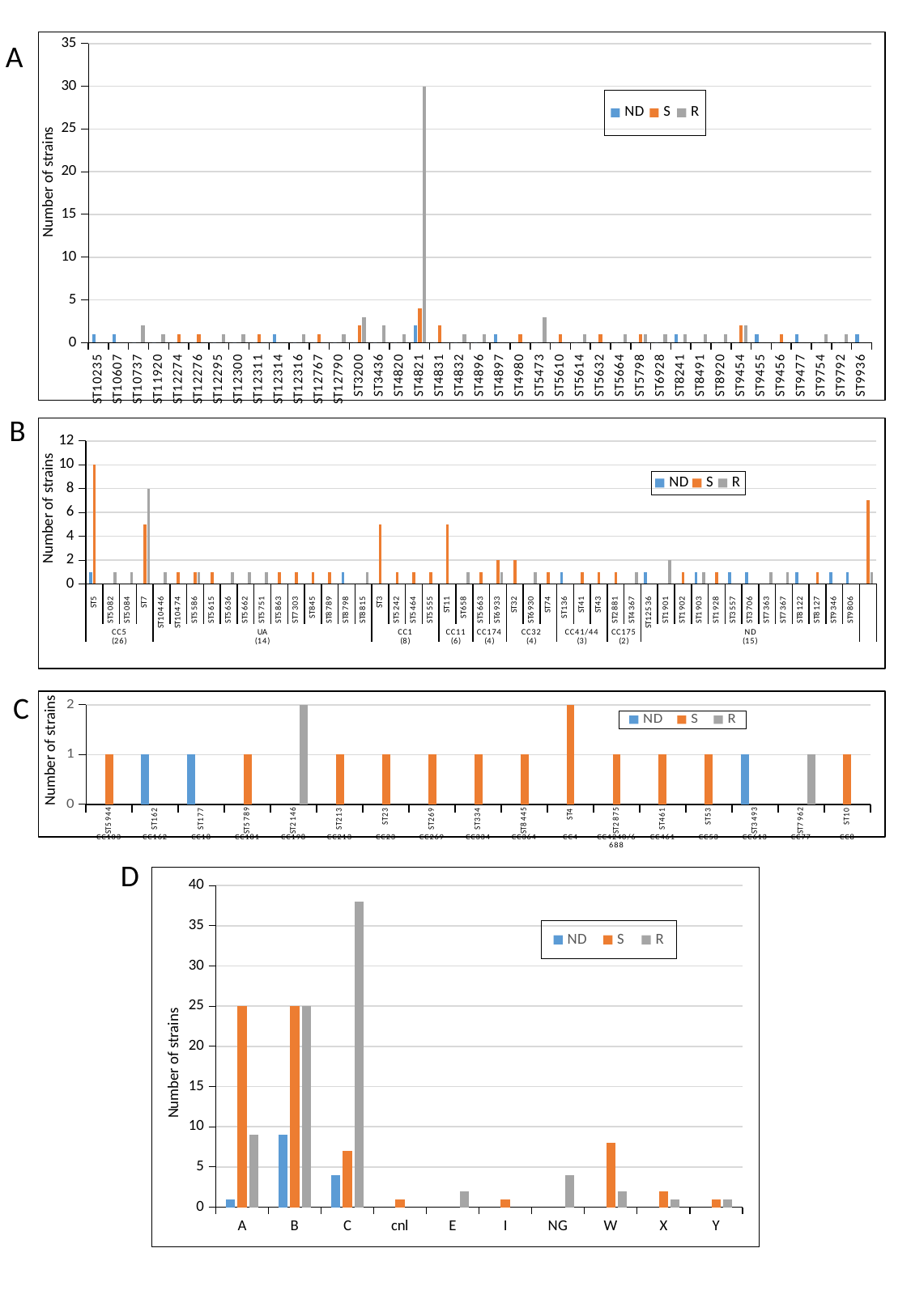
In chart D, what is the S value for category A? 25 What kind of chart is chart A? bar chart In chart C, what is the R value for ST2146? 2 In chart C, what is the S value for ST4? 2 In chart A, how many series does the legend list? 3 In chart D, is the R value for category C greater or less than 35? greater In chart D, how many categories are shown on the x axis? 10 In chart D, which category has the highest R value? C In chart B, what is the S value for ST5? 10 In chart B, what is the R value for ST7? 8 In chart A, what is the R value for ST4821? 30 In chart A, which category has the highest R value? ST4821